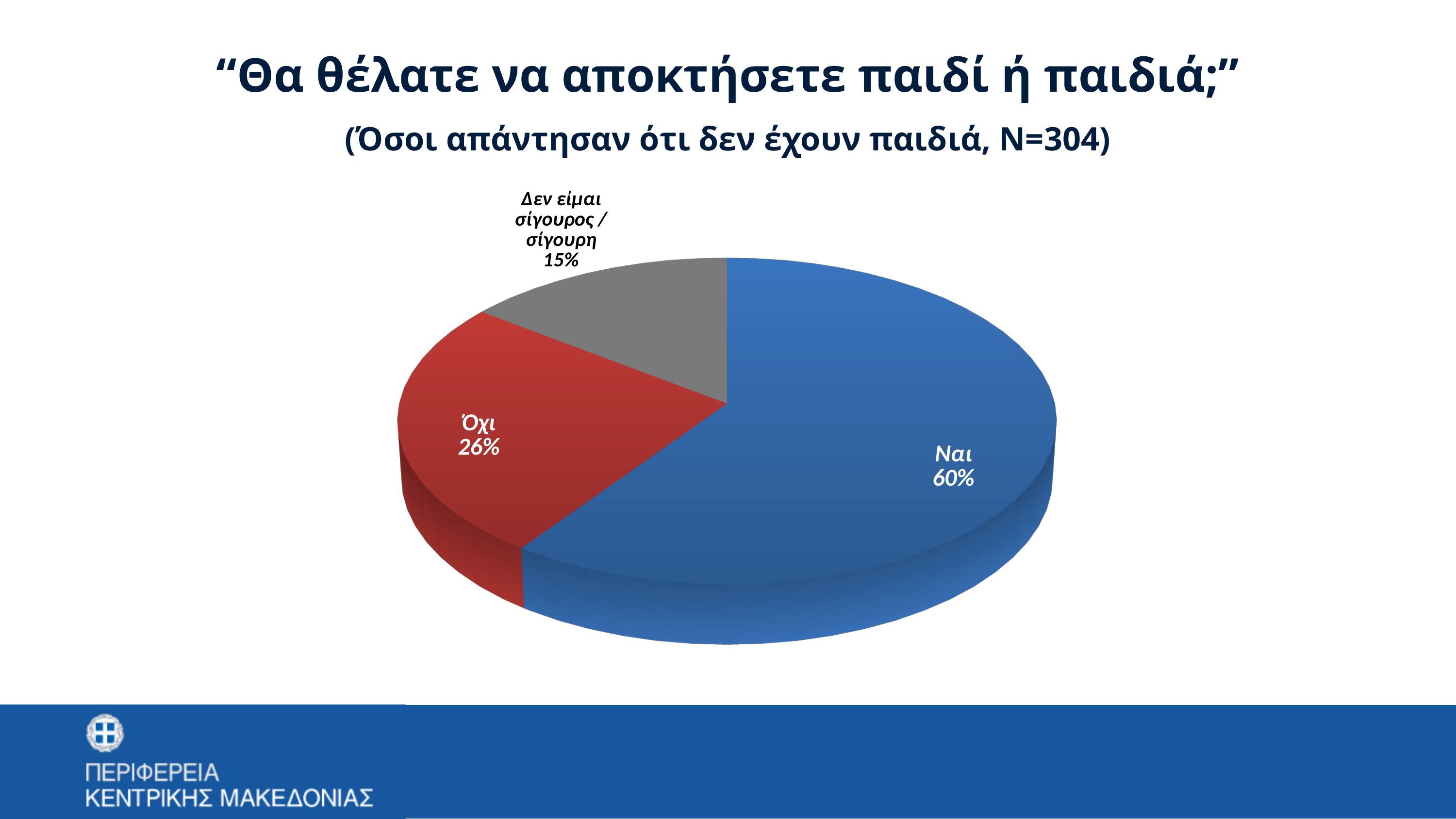
Which is larger, the share for "Όχι" or the share for "Δεν είμαι σίγουρος / σίγουρη"? Όχι How many slices does the pie chart have? 3 What is the difference in percentage points between "Ναι" and "Όχι"? 34 What is the sample size (N) stated in the chart subtitle? N=304 Which response has the largest share of the pie? Ναι Which response has the smallest share of the pie? Δεν είμαι σίγουρος / σίγουρη What kind of chart is shown on the slide? Pie chart What percentage of respondents answered "Ναι"? 60% What colour is the "Ναι" slice? Blue What percentage of respondents answered "Δεν είμαι σίγουρος / σίγουρη"? 15% What percentage of respondents answered "Όχι"? 26% What is the difference in percentage points between "Όχι" and "Δεν είμαι σίγουρος / σίγουρη"? 11